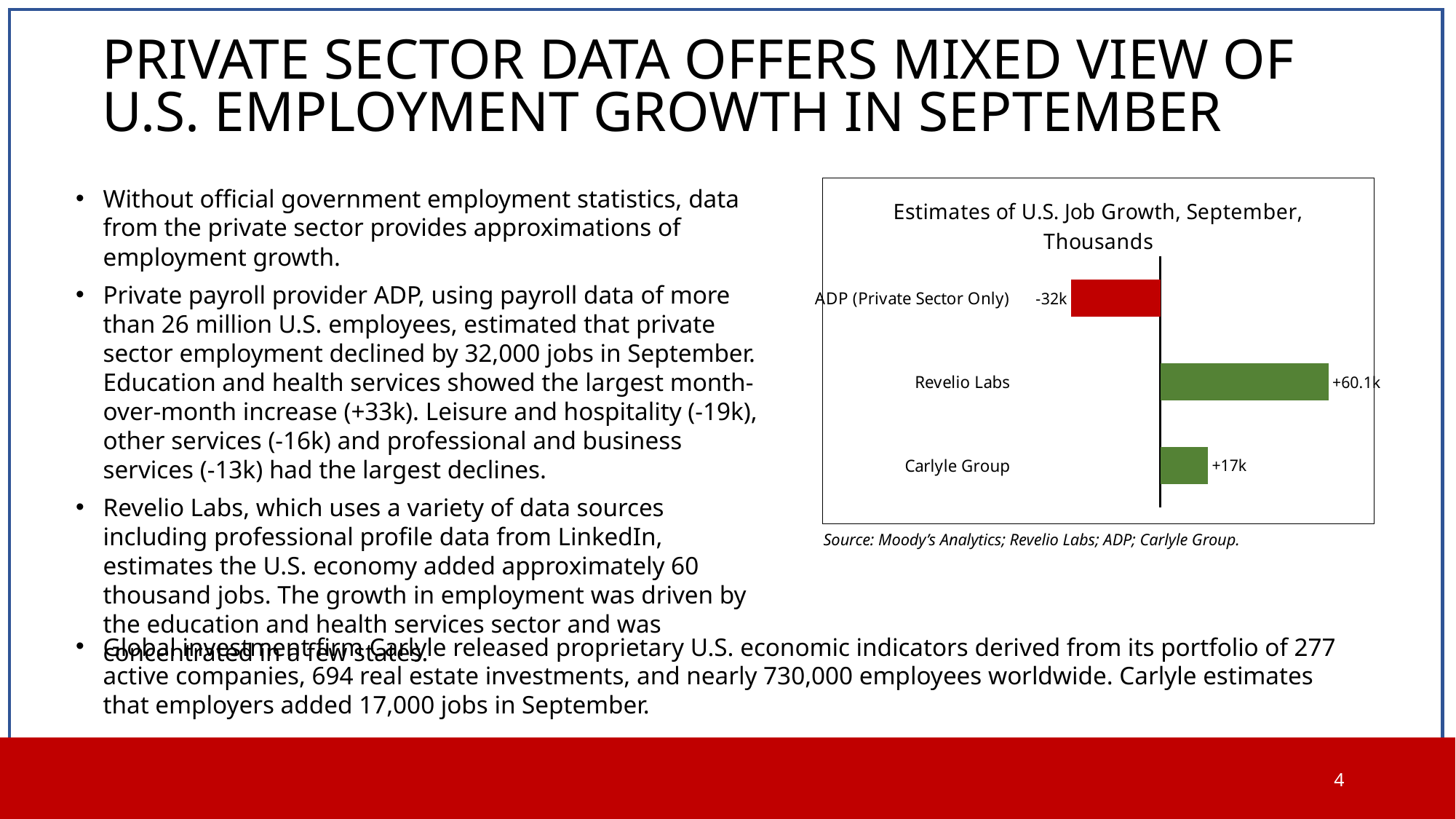
Which source shows the lowest estimate of U.S. job growth in the chart? ADP (Private Sector Only) What is the value for Carlyle Group in the chart? +17k What is the value for ADP (Private Sector Only) in the chart? -32k Which bar in the chart is coloured red? ADP (Private Sector Only) What is the title of the chart? Estimates of U.S. Job Growth, September, Thousands What is the difference between the Revelio Labs estimate and the Carlyle Group estimate? 43.1k What is the value for Revelio Labs in the chart? +60.1k What kind of chart is shown on the slide? Bar chart How many sources in the chart show a negative estimate? 1 Which source shows the highest estimate of U.S. job growth in the chart? Revelio Labs Which is larger, the Carlyle Group estimate or the ADP (Private Sector Only) estimate? Carlyle Group How many sources are shown in the chart? 3